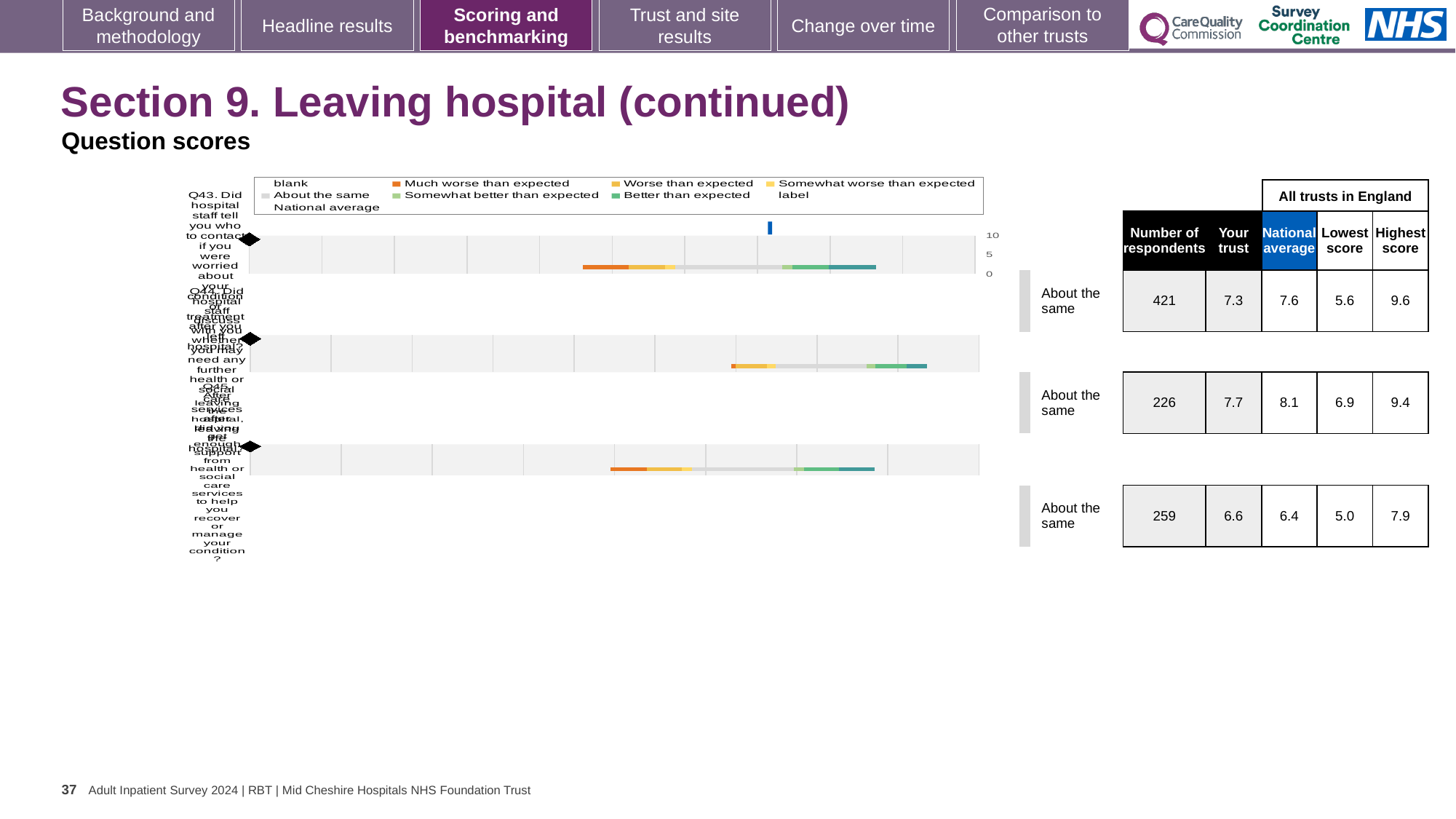
How many questions (Q43, Q44, Q45) are plotted as bars on this slide? 3 What is the 'Your trust' score for Q43 (Did hospital staff tell you who to contact if you were worried about your condition or treatment after you left hospital?)? 7.3 What is the highest score among all trusts in England for Q43? 9.6 For Q45, which is larger: the 'Your trust' score or the national average? Your trust How many respondents answered Q45 (After leaving hospital, did you get enough support from health or social care services to help you recover or manage your condition?)? 259 What is the national average score for Q44 (Did hospital staff discuss with you whether you may need any further health or social care services after leaving hospital?)? 8.1 What is the difference between the highest score and the lowest score for Q43? 4.0 What kind of chart is used to show the question scores on this slide? bar chart What benchmark category is shown for Q44 on this slide? About the same What is the maximum value shown on the score axis of the charts? 10 Which question has the highest 'Your trust' score on this slide? Q44 Which question has the lowest 'Your trust' score on this slide? Q45